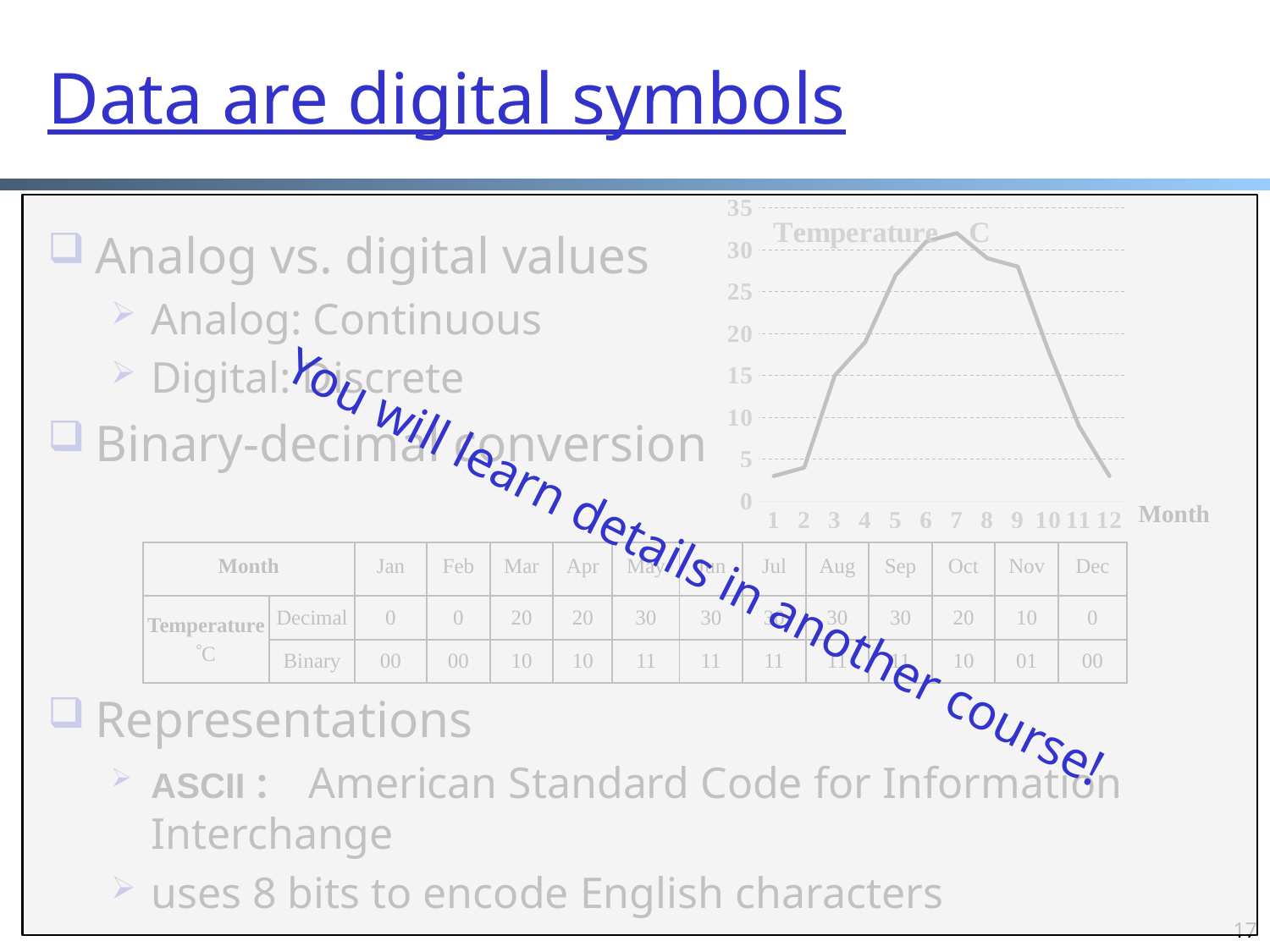
Is the value for month 9 greater or less than 25? greater What is the label of the x axis of the chart? Month What is the title of the chart? Temperature ℃ How many months are plotted along the x axis of the chart? 12 Is the value for month 12 greater or less than 10? less Which has the higher temperature, month 6 or month 1? month 6 Is the value for month 1 greater or less than 10? less What kind of chart is shown on the slide? line chart Does the temperature rise or fall from month 8 to month 12? fall